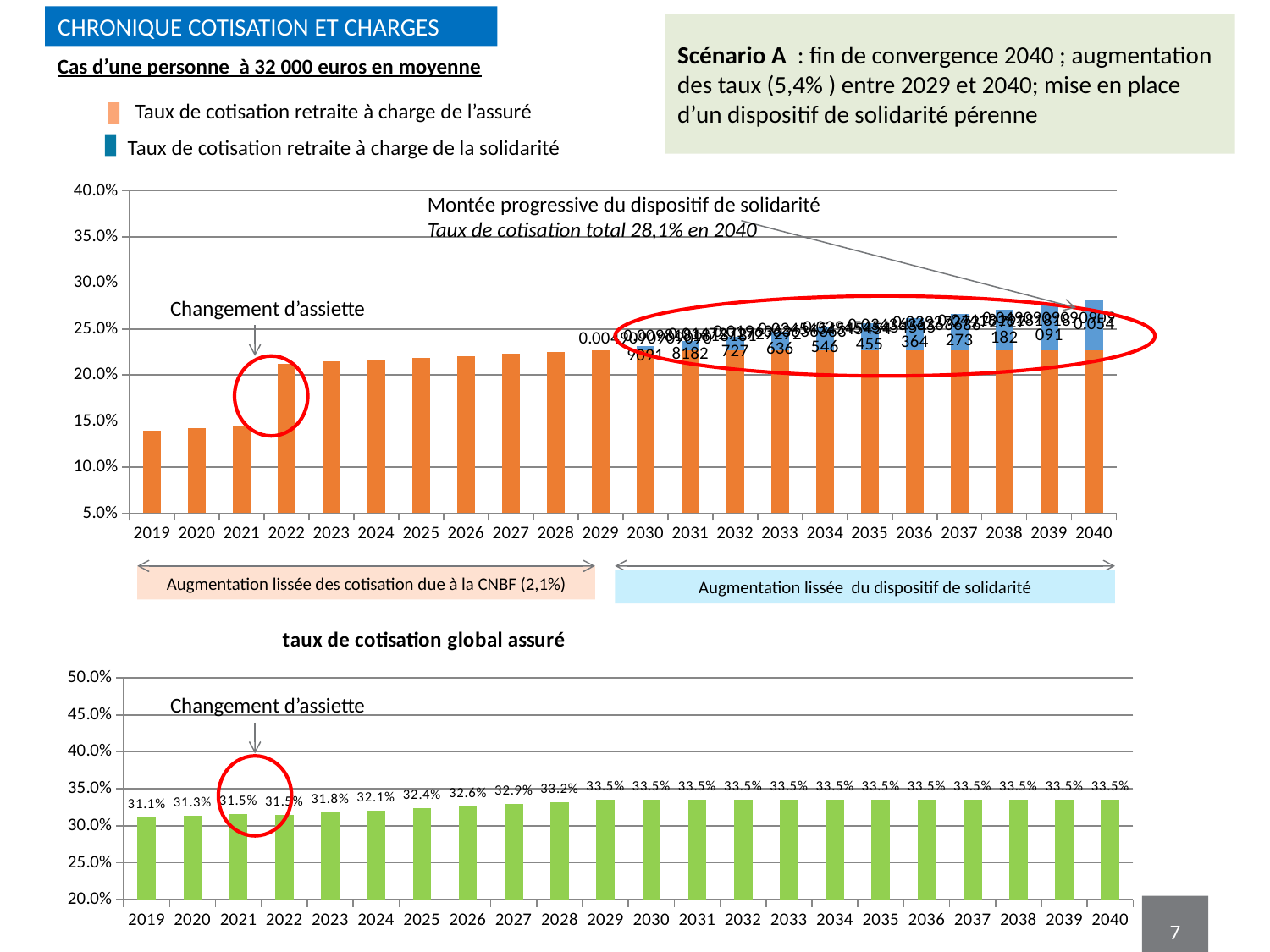
What kind of chart is the top chart? stacked bar chart In the bottom chart 'taux de cotisation global assuré', what is the value for 2019? 31.1% In the bottom chart 'taux de cotisation global assuré', what is the value for 2027? 32.9% In the bottom chart 'taux de cotisation global assuré', what is the value for 2023? 31.8% In the bottom chart 'taux de cotisation global assuré', what is the difference between the 2028 value and the 2019 value? 2.1% In the bottom chart 'taux de cotisation global assuré', do the values rise or fall from 2019 to 2029? rise How many series does the legend of the top chart list? 2 In the bottom chart 'taux de cotisation global assuré', which year has the lowest value? 2019 In the bottom chart 'taux de cotisation global assuré', what is the value for 2040? 33.5% In the bottom chart 'taux de cotisation global assuré', which is larger, the value for 2025 or the value for 2021? 2025 In the bottom chart 'taux de cotisation global assuré', how many years are shown on the x axis? 22 In the top chart, is the value for 2019 greater or less than 15%? less